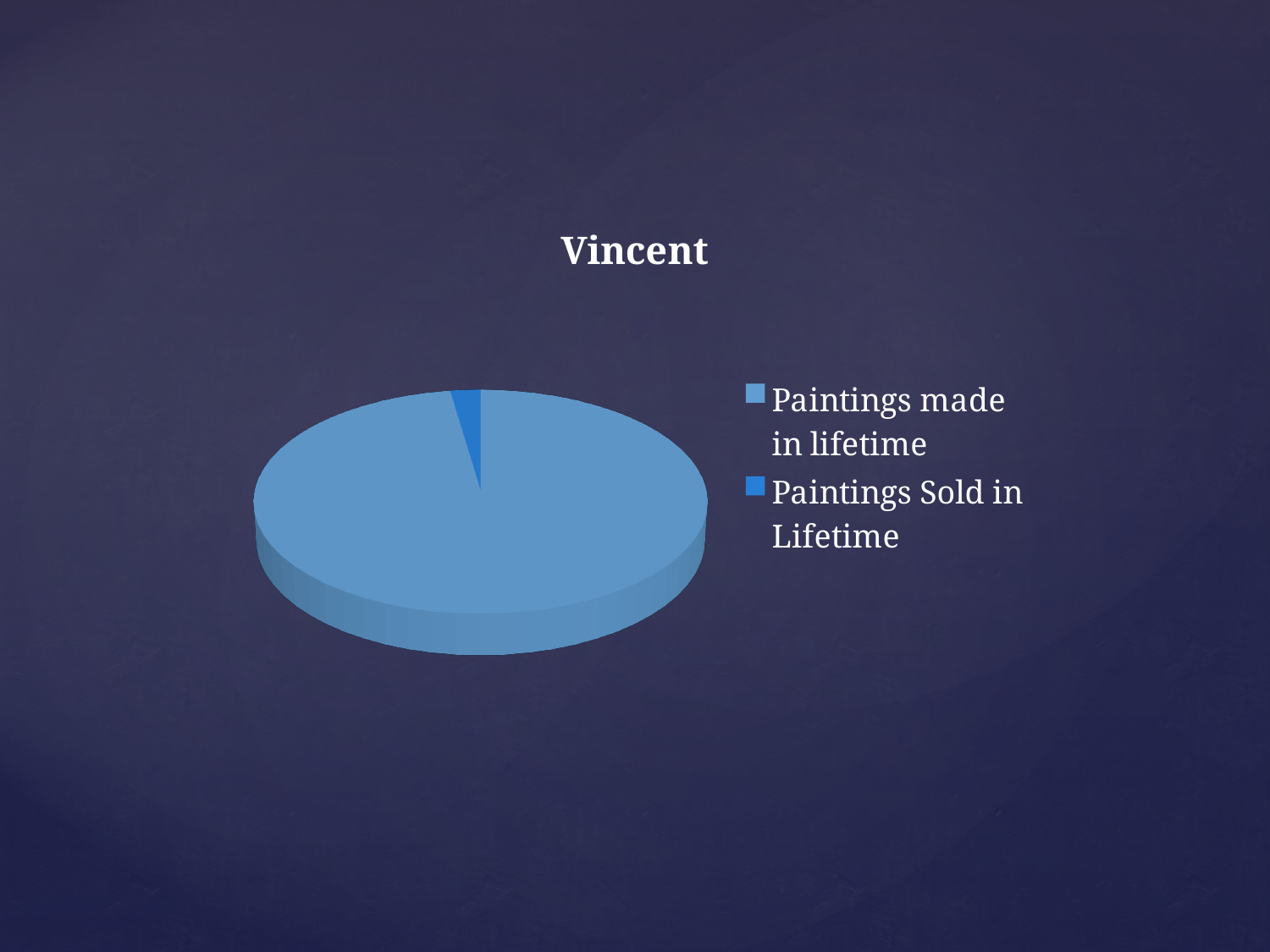
Which slice is the largest in the pie chart? Paintings made in lifetime Which is larger, the slice for Paintings made in lifetime or the slice for Paintings Sold in Lifetime? Paintings made in lifetime How many slices does the pie chart have? 2 What is the title of the chart? Vincent What kind of chart is shown on the slide? pie chart How many entries does the legend list? 2 What is the first entry listed in the legend? Paintings made in lifetime Which slice is the smallest in the pie chart? Paintings Sold in Lifetime